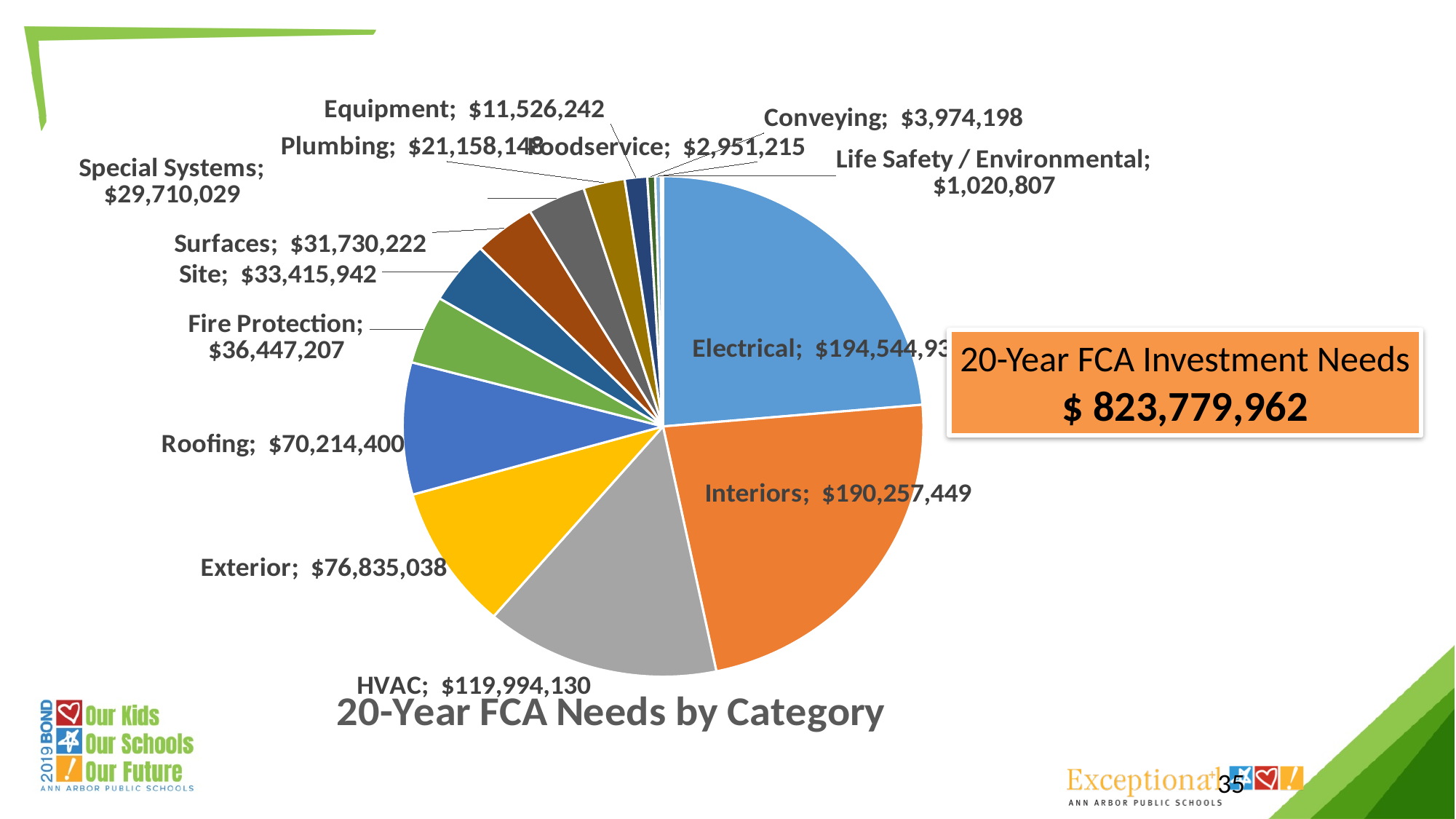
What is the value for HVAC? $119,994,130 What is the title of the chart? 20-Year FCA Needs by Category Which is larger, Conveying or Foodservice? Conveying What is the value for Roofing? $70,214,400 Which category has the smallest value? Life Safety / Environmental What is the difference between the HVAC and Exterior values? $43,159,092 Which category has the largest value? Electrical What is the value for Interiors? $190,257,449 What kind of chart is shown on the slide? Pie chart What total 20-Year FCA Investment Needs figure is shown in the box on the slide? $ 823,779,962 What is the value for Life Safety / Environmental? $1,020,807 How many categories does the pie chart show? 14